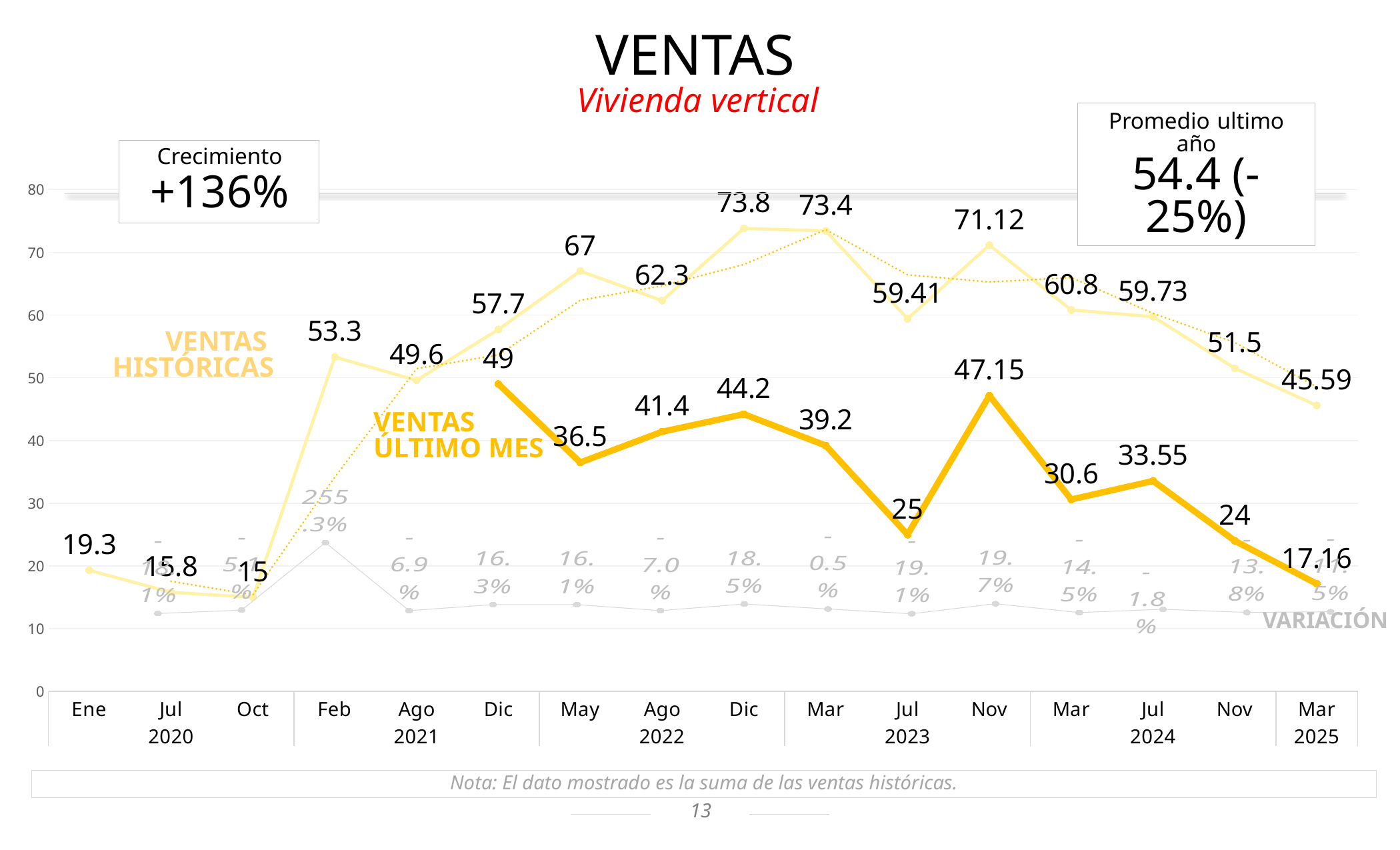
In which period does the VENTAS HISTÓRICAS series have its lowest value? Oct 2020 What growth percentage (Crecimiento) is shown in the box on the slide? +136% What is the VENTAS HISTÓRICAS value for Mar 2025? 45.59 How many time periods are shown on the x axis? 16 What type of chart is shown on the slide? line chart What is the VENTAS ÚLTIMO MES value for Nov 2023? 47.15 Which is larger: the VENTAS ÚLTIMO MES value for Dic 2021 or for Mar 2024? Dic 2021 In which period does the VENTAS HISTÓRICAS series reach its highest value? Dic 2022 What is the difference between the VENTAS HISTÓRICAS value for Feb 2021 and for Oct 2020? 38.3 In which period does the VENTAS ÚLTIMO MES series have its lowest value? Mar 2025 What is the VENTAS HISTÓRICAS value for Dic 2022? 73.8 What is the value shown for 'Promedio ultimo año'? 54.4 (-25%)